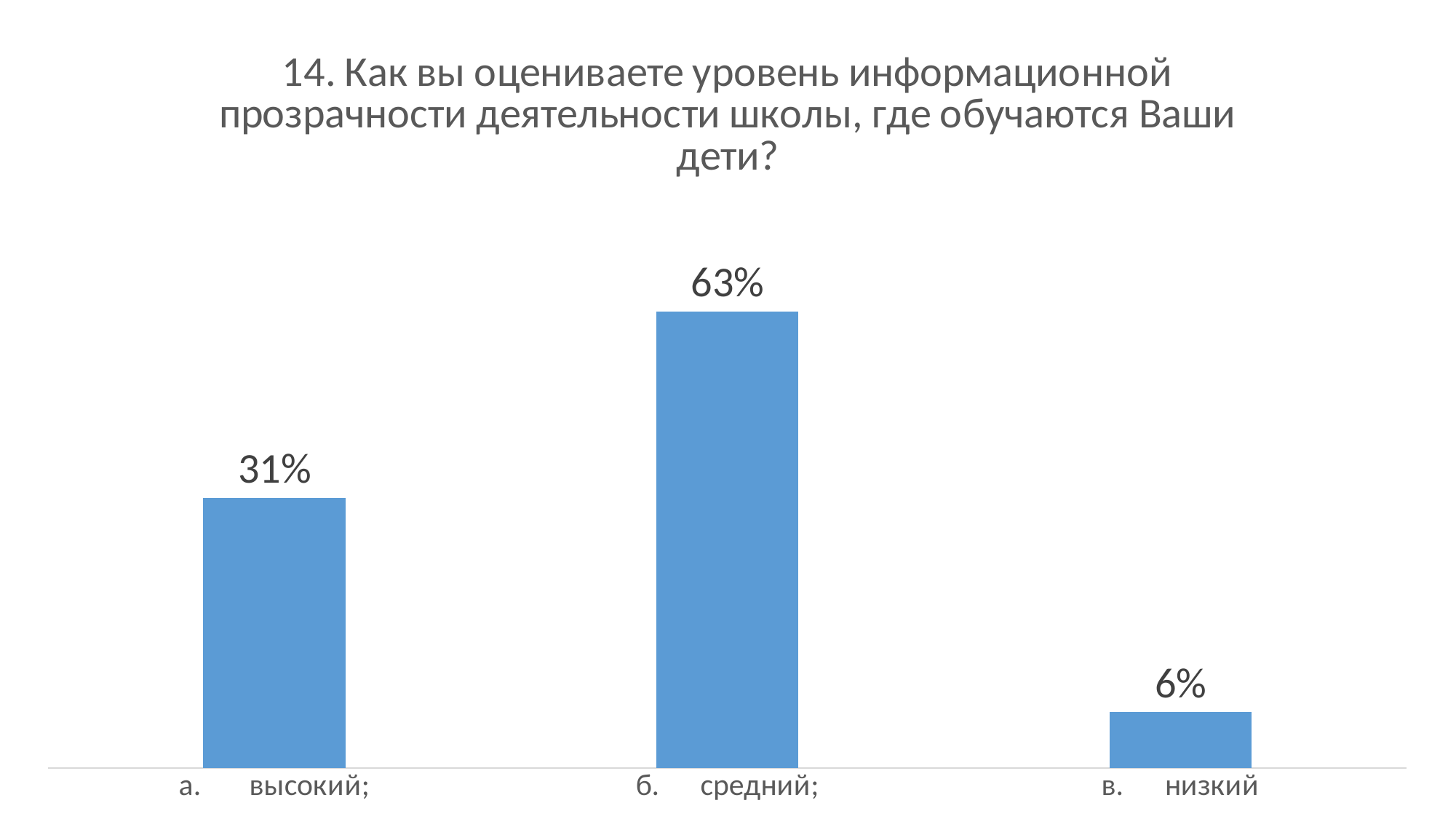
What is the difference between the values for "средний" and "высокий"? 32% How many categories are shown in the chart? 3 Which category has the highest value? средний What colour are the bars in the chart? blue What is the value for the category "низкий"? 6% Which is larger, the value for "высокий" or the value for "низкий"? высокий What kind of chart is shown on the slide? bar chart What is the title of the chart? 14. Как вы оцениваете уровень информационной прозрачности деятельности школы, где обучаются Ваши дети? What is the value for the category "высокий"? 31% What is the value for the category "средний"? 63% What is the difference between the values for "высокий" and "низкий"? 25% Which category has the lowest value? низкий